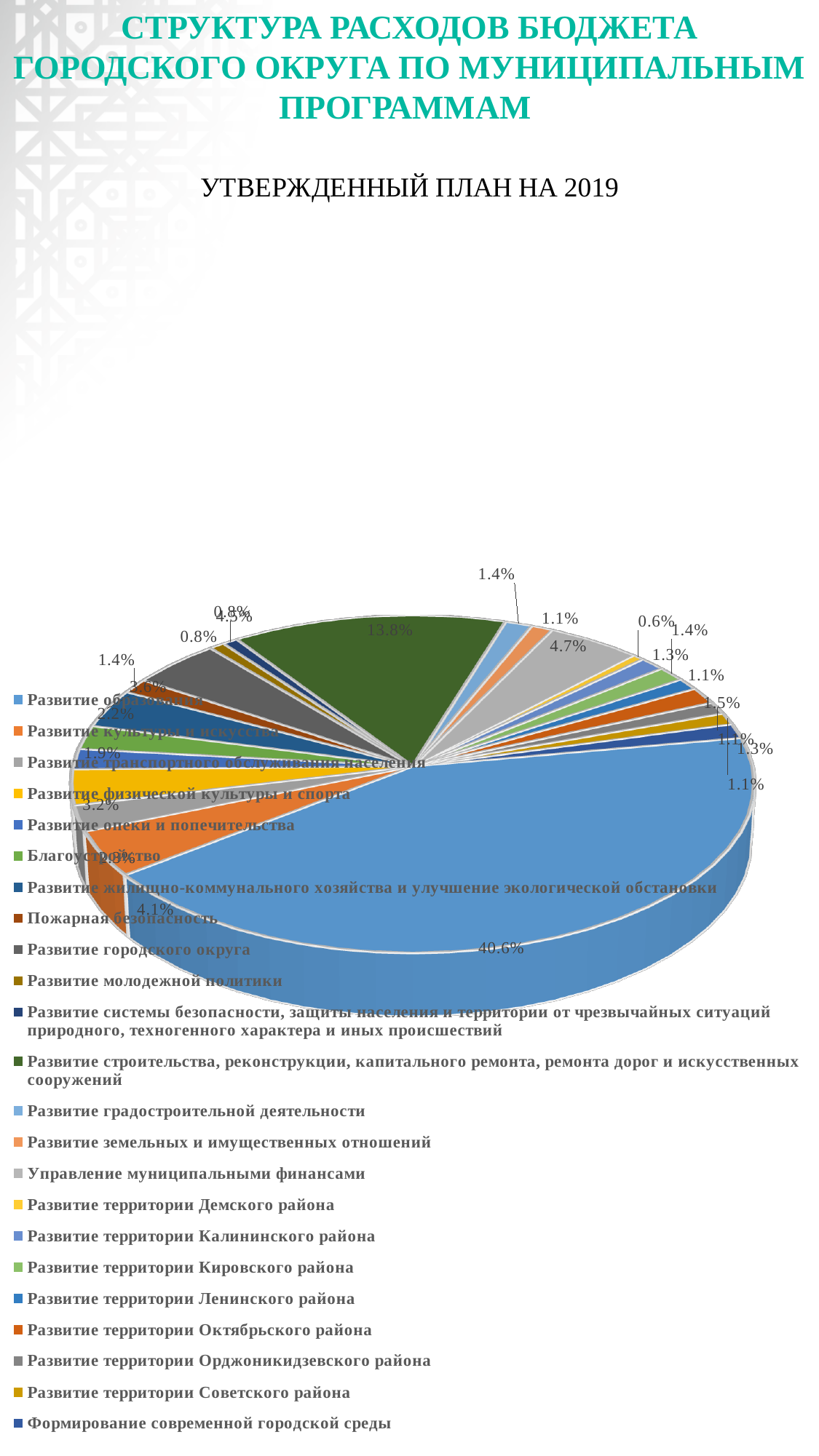
Which municipal programme has the largest share of the budget expenditure? Развитие образования What kind of chart is shown on the slide? pie chart How many programmes are listed in the chart legend? 23 What share of the budget expenditure goes to Развитие градостроительной деятельности? 1.4% What year is the approved plan shown in the chart for? 2019 Which has a larger share: Управление муниципальными финансами or Развитие градостроительной деятельности? Управление муниципальными финансами Which has a larger share: Развитие образования or Развитие строительства, реконструкции, капитального ремонта, ремонта дорог и искусственных сооружений? Развитие образования What share of the budget expenditure goes to Развитие строительства, реконструкции, капитального ремонта, ремонта дорог и искусственных сооружений? 13.8% What share of the budget expenditure goes to Развитие земельных и имущественных отношений? 1.1% What share of the budget expenditure goes to Развитие образования? 40.6% What share of the budget expenditure goes to Управление муниципальными финансами? 4.7% By how many percentage points does the share of Развитие образования exceed the share of Развитие строительства, реконструкции, капитального ремонта, ремонта дорог и искусственных сооружений? 26.8%